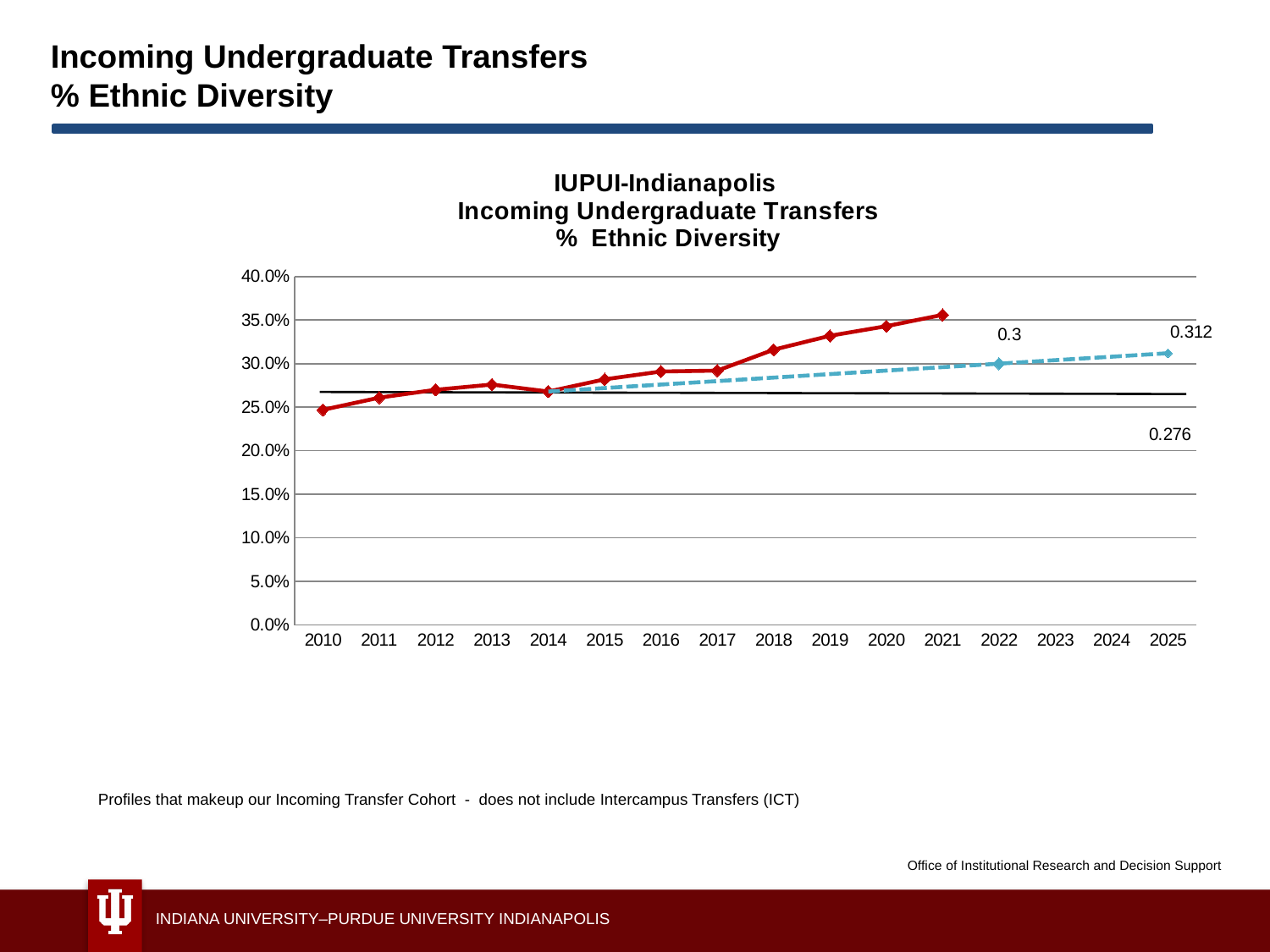
Is the value of the red line for 2019 greater or less than 30%? greater Is the value of the red line for 2010 greater or less than 30%? less Does the red line generally rise or fall from 2010 to 2021? rise What kind of chart is shown on the slide? line chart How many years are shown along the x axis of the chart? 16 Is the value of the red line for 2014 greater or less than 30%? less What is the difference between the labelled values at 2025 (0.312) and 2022 (0.3) on the dashed line? 0.012 What value is labelled on the dashed projection line at 2025? 0.312 What value is labelled on the dashed projection line at 2022? 0.3 In which year does the red line have its lowest value? 2010 What value is labelled next to the flat black line at the right of the chart? 0.276 In which year does the red line reach its highest value? 2021